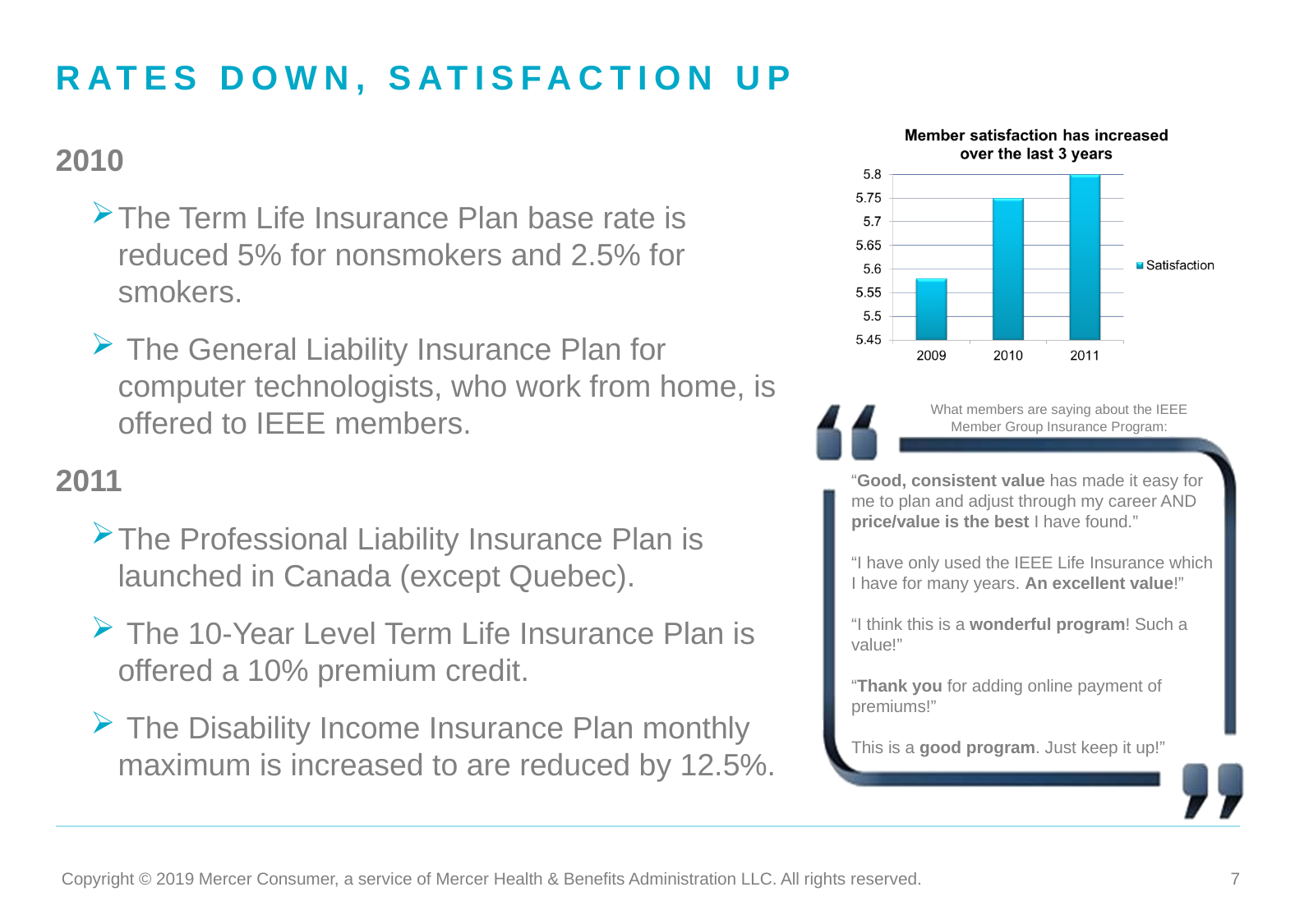
Is the satisfaction value for 2009 greater or less than 5.55? greater Which year has the highest satisfaction value? 2011 What is the title of the chart? Member satisfaction has increased over the last 3 years What is the satisfaction value for 2011? 5.8 How many series does the chart legend list? 1 What kind of chart is shown on the slide? bar chart Do satisfaction values rise or fall from 2009 to 2011? rise How many years are shown on the x axis of the chart? 3 What is the satisfaction value for 2010? 5.75 Is the satisfaction value for 2009 greater or less than 5.6? less What is the name of the series shown in the chart legend? Satisfaction Which year has the lowest satisfaction value? 2009